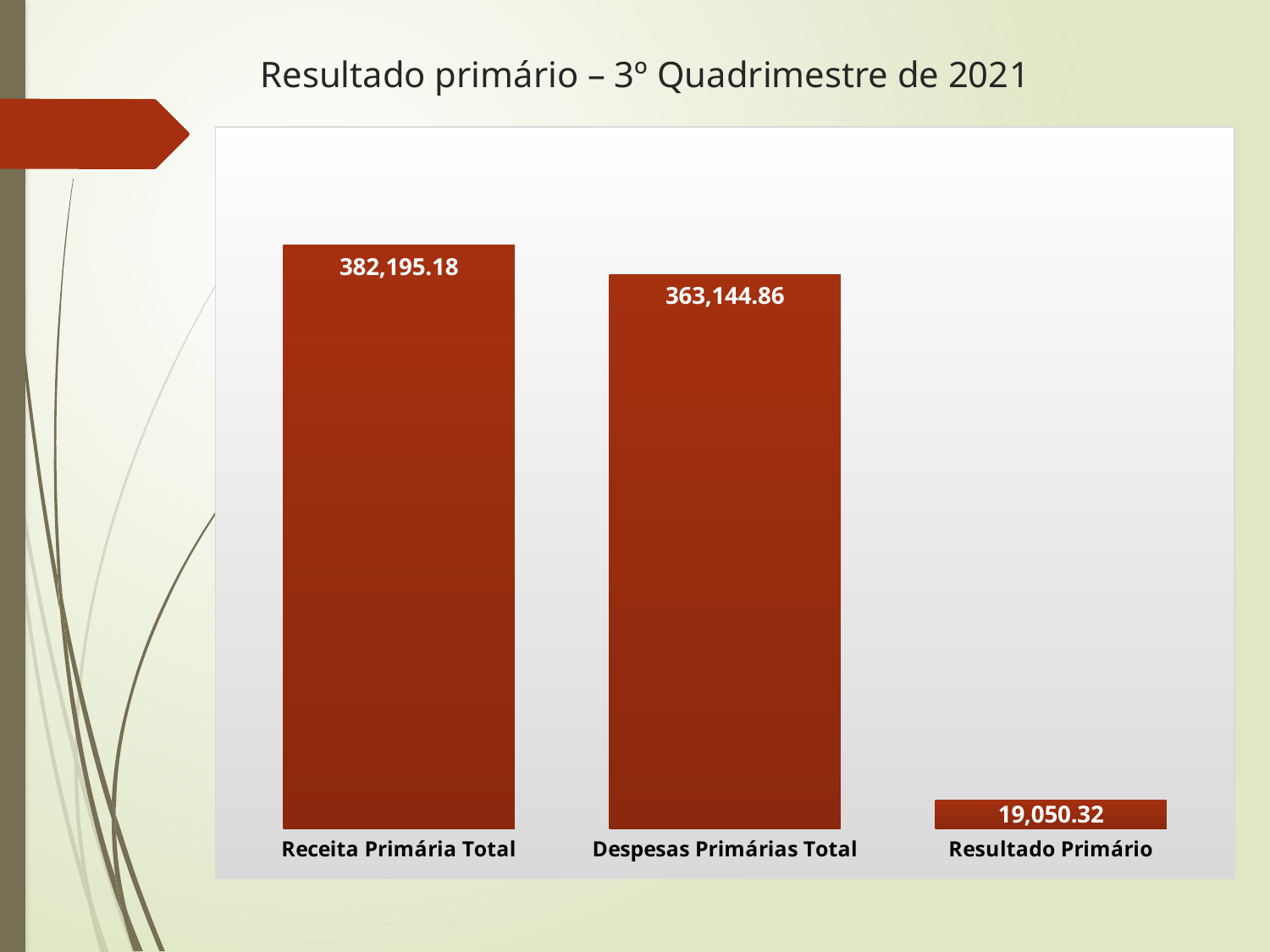
What is the value for Despesas Primárias Total? 363,144.86 What is the title of the slide? Resultado primário – 3º Quadrimestre de 2021 What is the difference between Despesas Primárias Total and Resultado Primário? 344,094.54 Which category has the highest value? Receita Primária Total Which is larger, Receita Primária Total or Despesas Primárias Total? Receita Primária Total What kind of chart is shown on the slide? Bar chart Which is larger, Despesas Primárias Total or Resultado Primário? Despesas Primárias Total What is the value for Receita Primária Total? 382,195.18 What is the value for Resultado Primário? 19,050.32 Which category has the lowest value? Resultado Primário What is the difference between Receita Primária Total and Despesas Primárias Total? 19,050.32 How many categories are shown in the chart? 3